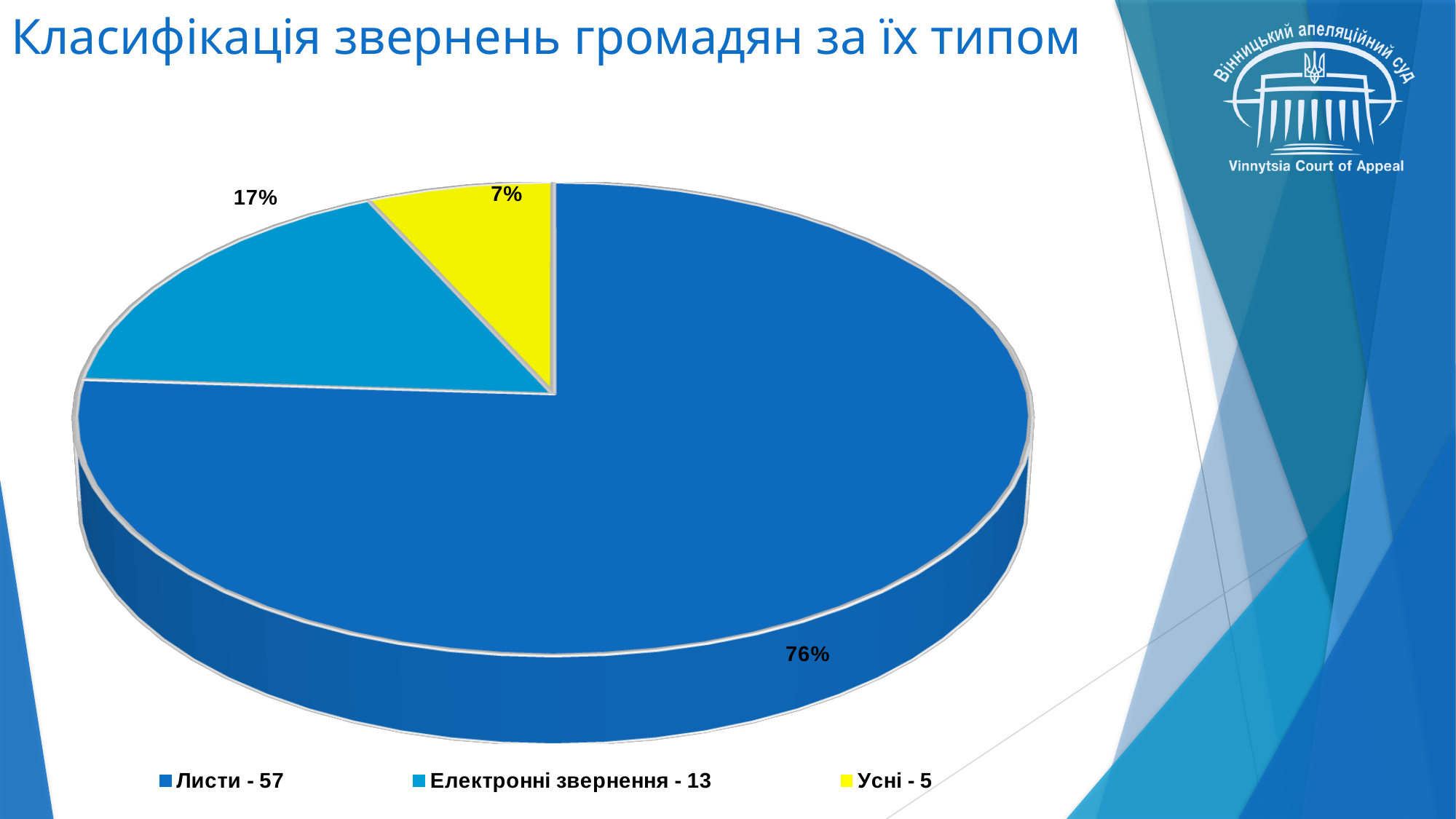
What percentage share is shown for the "Електронні звернення - 13" slice? 17% Which slice is larger, "Електронні звернення - 13" or "Усні - 5"? Електронні звернення - 13 What is the difference in percentage points between the "Листи - 57" slice and the "Електронні звернення - 13" slice? 59 Which category has the largest slice of the pie? Листи - 57 Which category has the smallest slice of the pie? Усні - 5 What percentage share is shown for the "Усні - 5" slice? 7% What colour is the "Усні - 5" slice in the pie chart? yellow What is the difference in percentage points between the "Електронні звернення - 13" slice and the "Усні - 5" slice? 10 What percentage share is shown for the "Листи - 57" slice? 76% What is the title of the slide containing the pie chart? Класифікація звернень громадян за їх типом What kind of chart is shown on the slide? pie chart How many slices does the pie chart have? 3